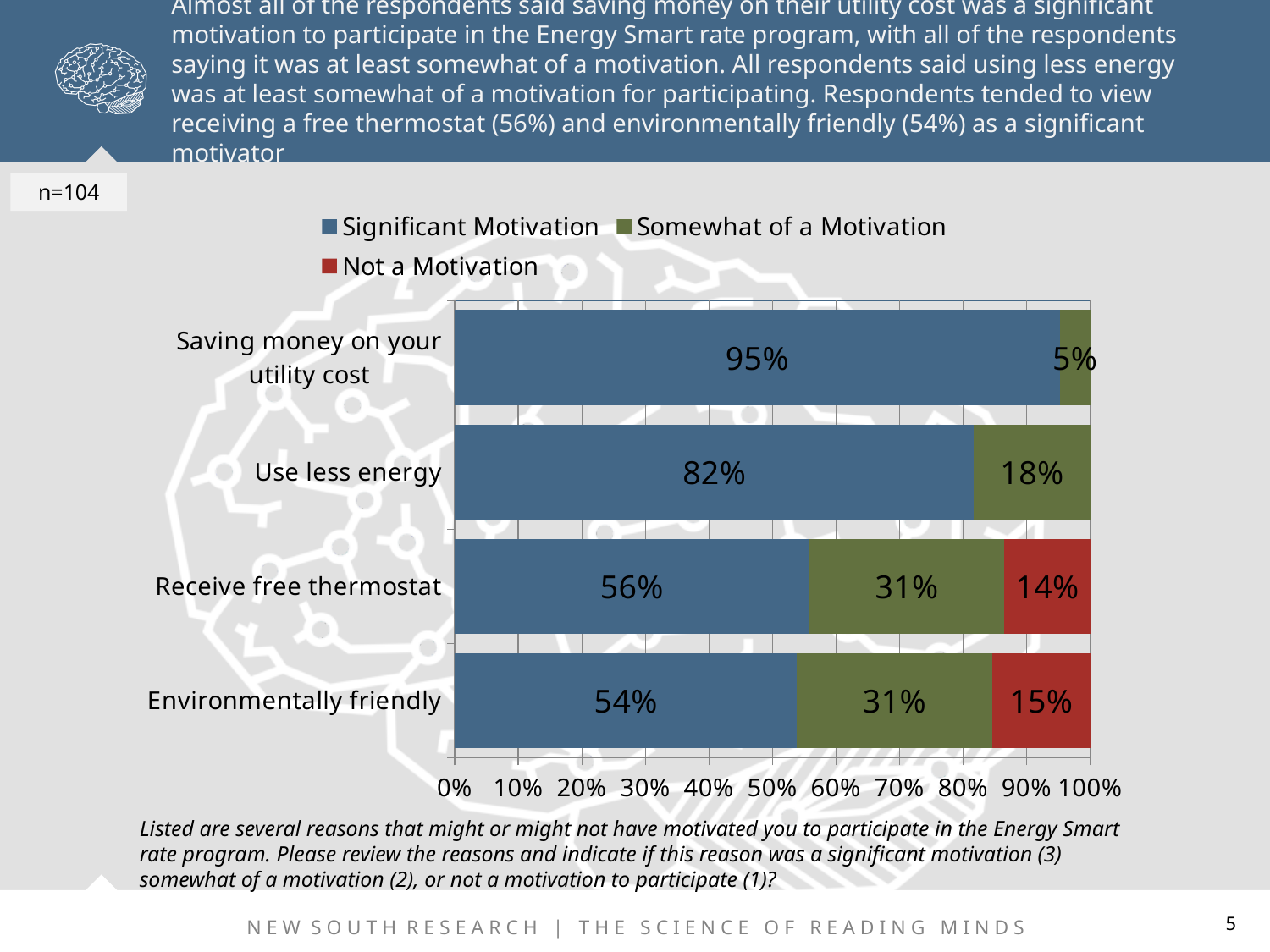
What percentage of respondents said saving money on their utility cost was a significant motivation? 95% What percentage of respondents said receiving a free thermostat was not a motivation? 14% What kind of chart is shown on the slide? Stacked bar chart How many series does the legend list? 3 What percentage of respondents said being environmentally friendly was a significant motivation? 54% What is the sample size shown on the slide? n=104 Which reason has the lowest share of respondents rating it a significant motivation? Environmentally friendly What percentage of respondents said using less energy was somewhat of a motivation? 18% Which reason has the highest share of respondents rating it a significant motivation? Saving money on your utility cost How many reasons (categories) are shown in the chart? 4 Which has a larger 'Not a Motivation' share: receiving a free thermostat or being environmentally friendly? Environmentally friendly How many percentage points higher is the significant motivation share for saving money on your utility cost than for using less energy? 13 percentage points